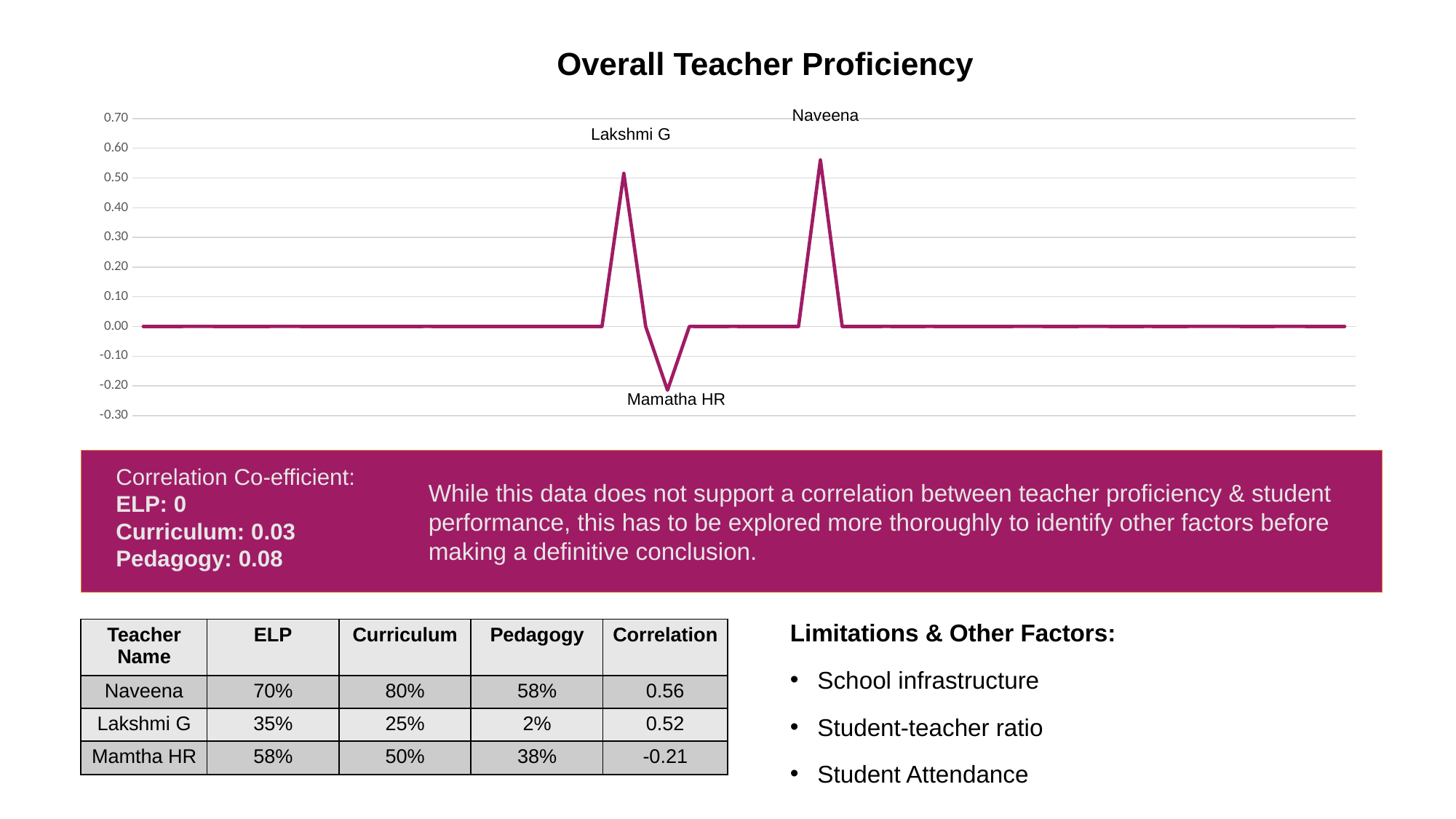
Is the value for Lakshmi G greater or less than 0.40? greater Which labeled teacher has the highest point on the chart? Naveena What is the title of the chart? Overall Teacher Proficiency Is the value for Mamatha HR greater or less than -0.10? less Which is larger on the chart, the value for Naveena or the value for Lakshmi G? Naveena Is the value for Mamatha HR greater or less than 0.00? less What is the highest value shown on the chart's y-axis? 0.70 What kind of chart is shown on the slide? line chart Which is larger on the chart, the value for Lakshmi G or the value for Mamatha HR? Lakshmi G Which labeled teacher has the lowest point on the chart? Mamatha HR How many teachers are labeled on the chart? 3